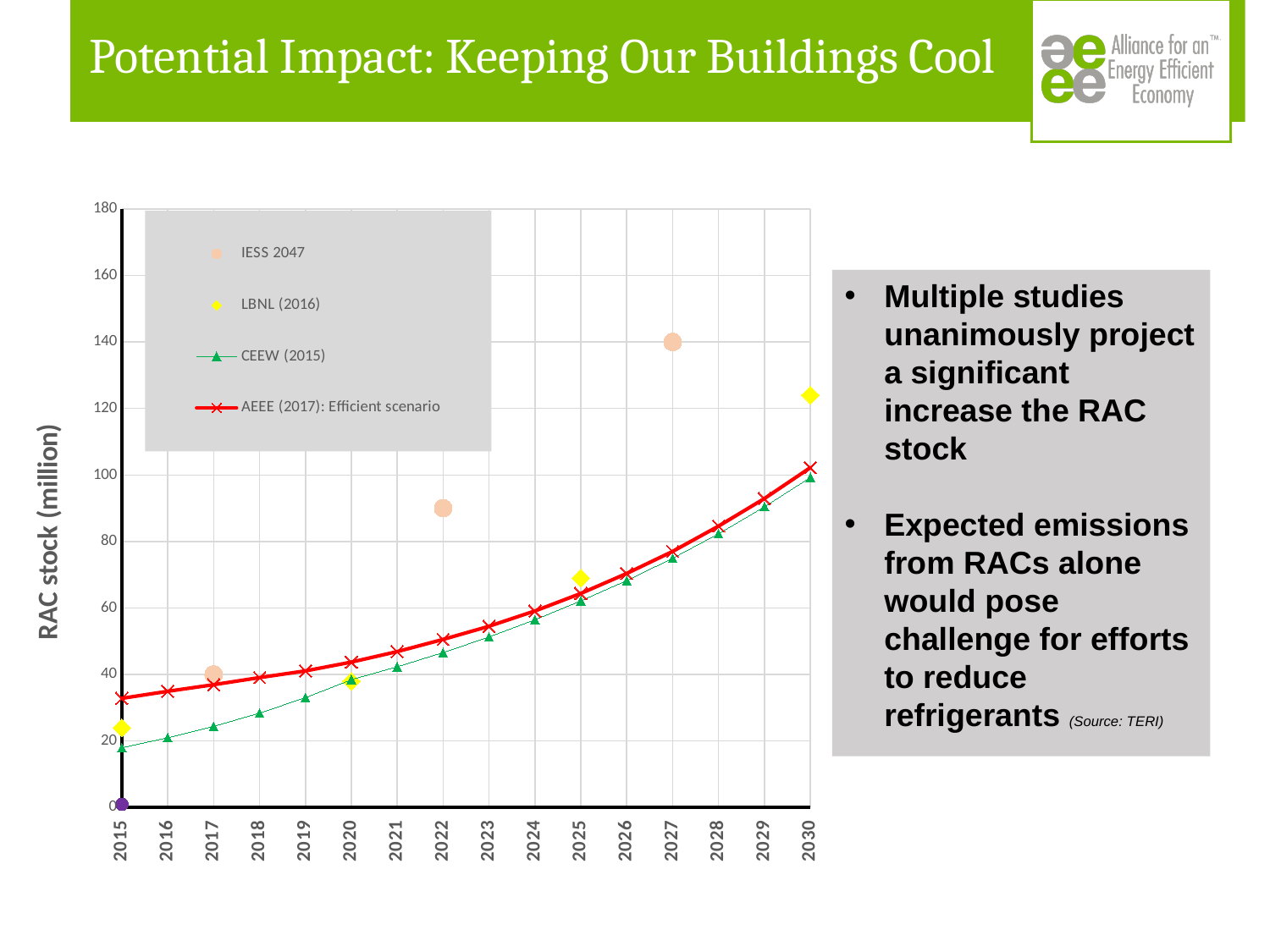
Is the CEEW (2015) value for 2015 greater or less than 20? less Is the LBNL (2016) value for 2030 greater or less than 100? greater What kind of chart is shown on the slide? Line chart In 2015, which is higher: the AEEE (2017): Efficient scenario value or the CEEW (2015) value? AEEE (2017): Efficient scenario Does the AEEE (2017): Efficient scenario series rise or fall from 2015 to 2030? Rise Is the IESS 2047 value for 2022 greater or less than 80? greater In 2027, which is higher: the IESS 2047 value or the AEEE (2017): Efficient scenario value? IESS 2047 How many years are shown along the x axis of the chart? 16 Which series is drawn as a thick red line with x markers? AEEE (2017): Efficient scenario What is the label of the vertical axis of the chart? RAC stock (million) How many series does the chart legend list? 4